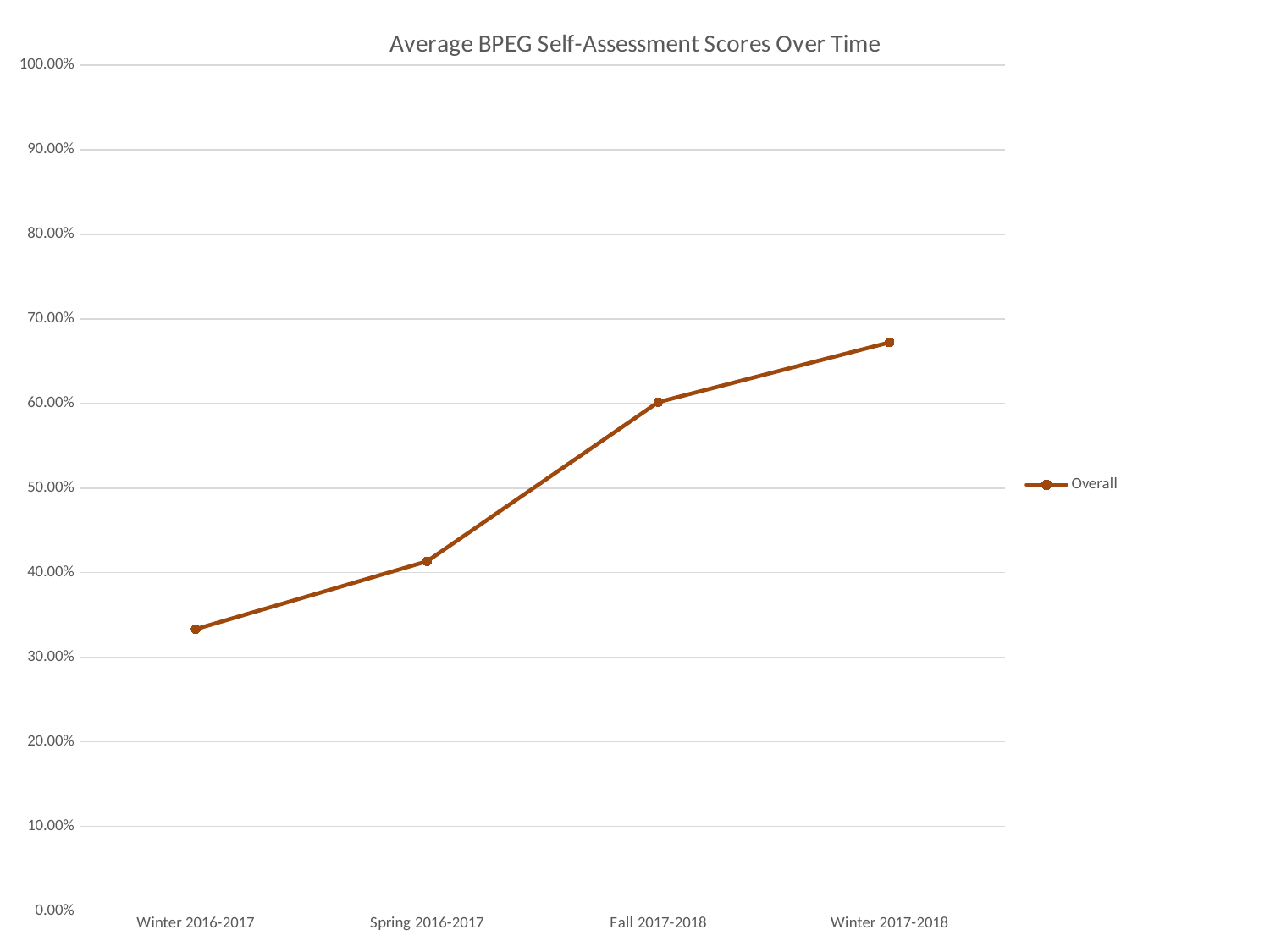
Is the Overall score for Winter 2016-2017 greater or less than 30.00%? greater What is the title of the chart? Average BPEG Self-Assessment Scores Over Time Is the Overall score for Spring 2016-2017 greater or less than 50.00%? less What is the name of the series shown in the legend? Overall Which time period has the highest Overall score? Winter 2017-2018 Which has the larger Overall score, Spring 2016-2017 or Fall 2017-2018? Fall 2017-2018 Is the Overall score for Winter 2017-2018 greater or less than 70.00%? less Do the Overall scores rise or fall from Winter 2016-2017 to Winter 2017-2018? rise What kind of chart is shown on the slide? line chart How many series does the legend list? 1 How many time periods are plotted along the x axis? 4 Which time period has the lowest Overall score? Winter 2016-2017